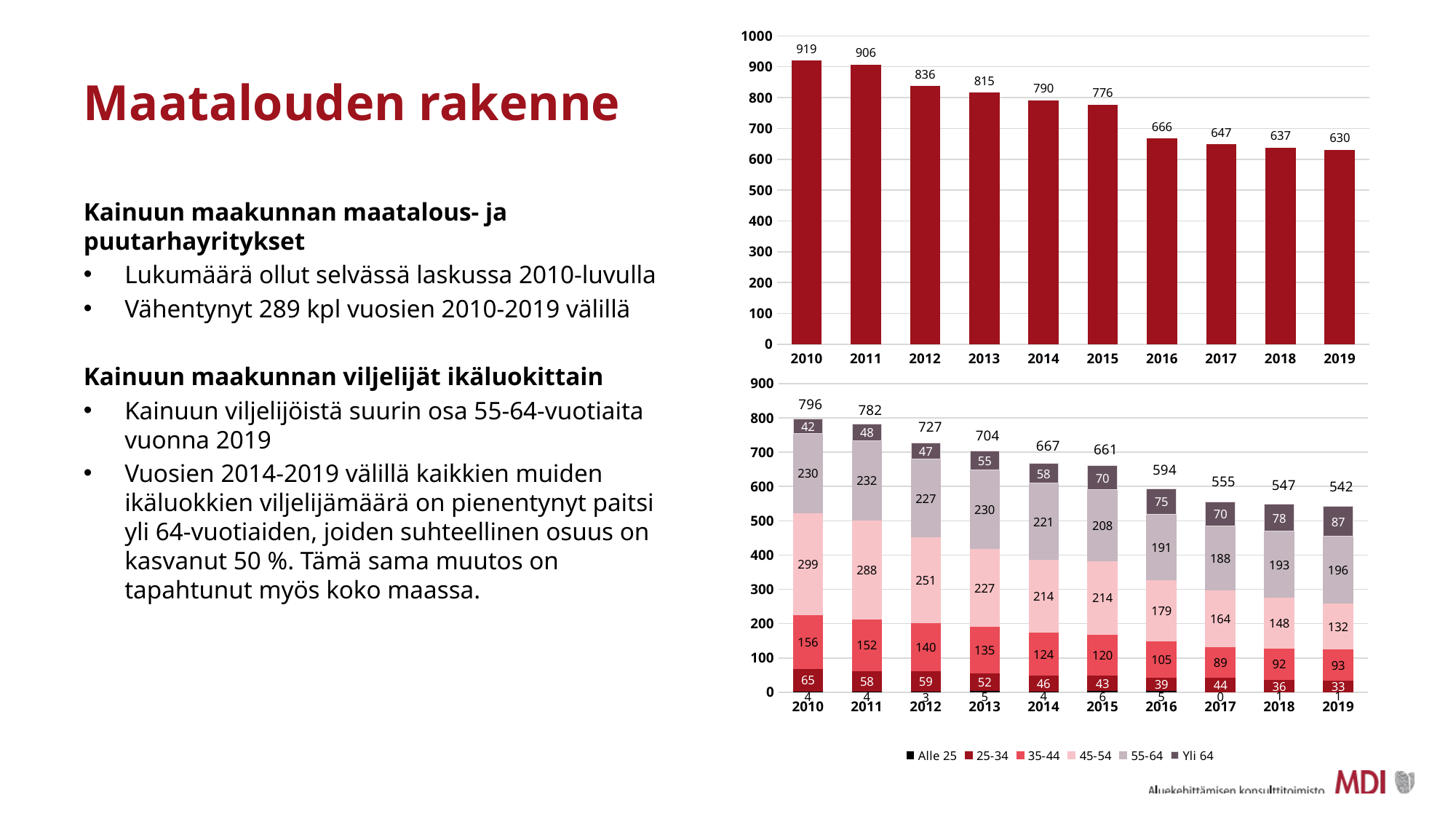
How many years are shown on the x axis of the top chart? 10 In the top chart, what is the value for 2019? 630 In the bottom chart, what is the value for the 55-64 series in 2019? 196 In the top chart, what is the difference between the values for 2010 and 2019? 289 In the bottom chart, what is the total of the stacked bar for 2010? 796 What kind of chart is the bottom chart? stacked bar chart In the top chart, do the values rise or fall from 2010 to 2019? fall In the bottom chart, which is larger in 2019: the 45-54 series or the Yli 64 series? 45-54 How many series does the legend of the bottom chart list? 6 In the bottom chart, what is the difference between the Yli 64 values for 2010 and 2019? 45 In the top chart, what is the value for 2010? 919 In the top chart, which year has the lowest value? 2019